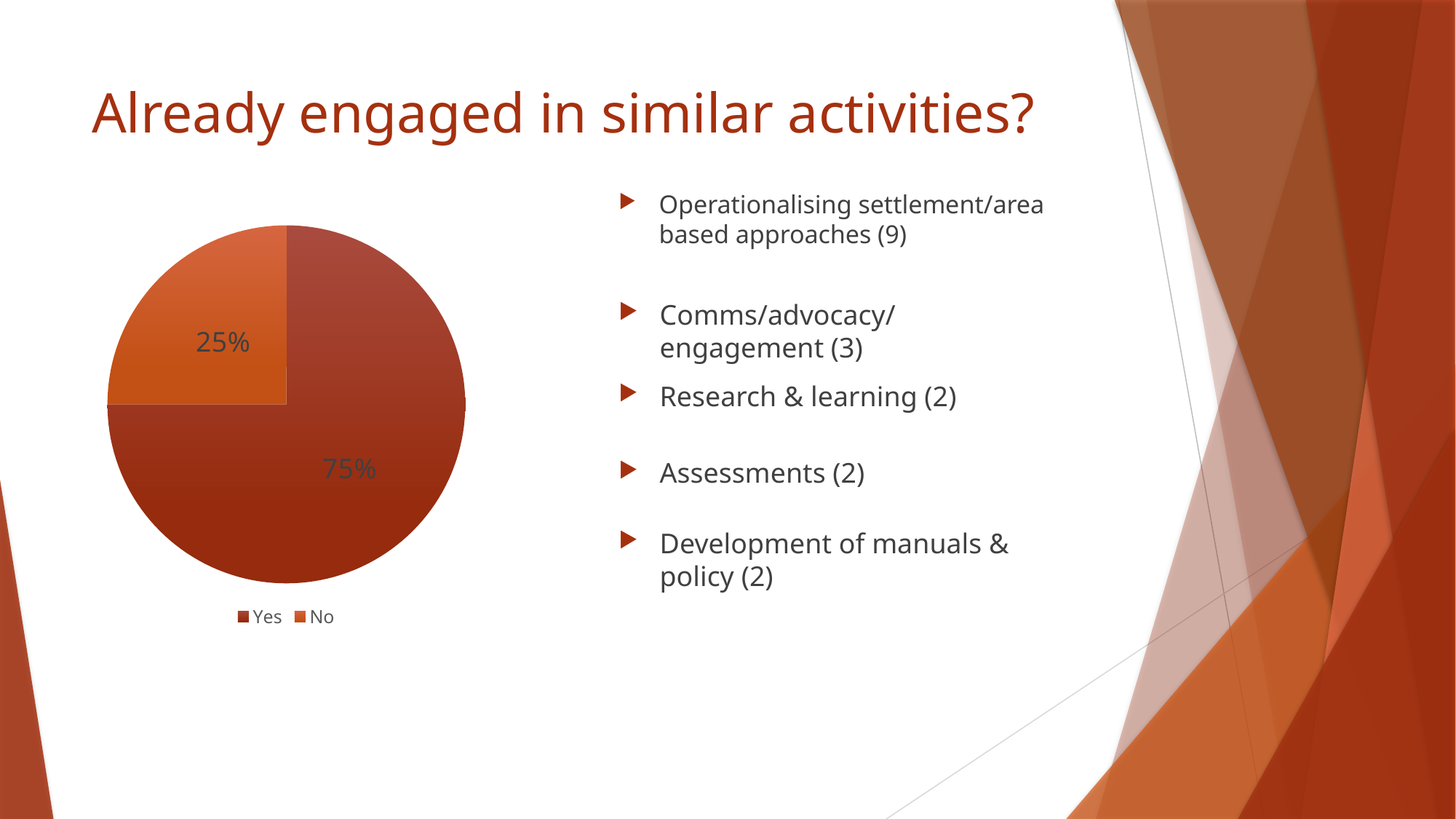
What percentage of the pie chart is labelled No? 25% What percentage of the pie chart is labelled Yes? 75% What is the difference in percentage points between the Yes and No slices? 50 Which slice of the pie chart is the smallest? No How many entries does the pie chart legend list? 2 Which is larger in the pie chart, Yes or No? Yes What share of the pie does the No slice represent? 25% Which slice of the pie chart is the largest? Yes What kind of chart is shown on the slide? pie chart Which legend entry is shown in the lighter orange colour? No How many slices does the pie chart have? 2 What are the two legend entries of the pie chart? Yes and No